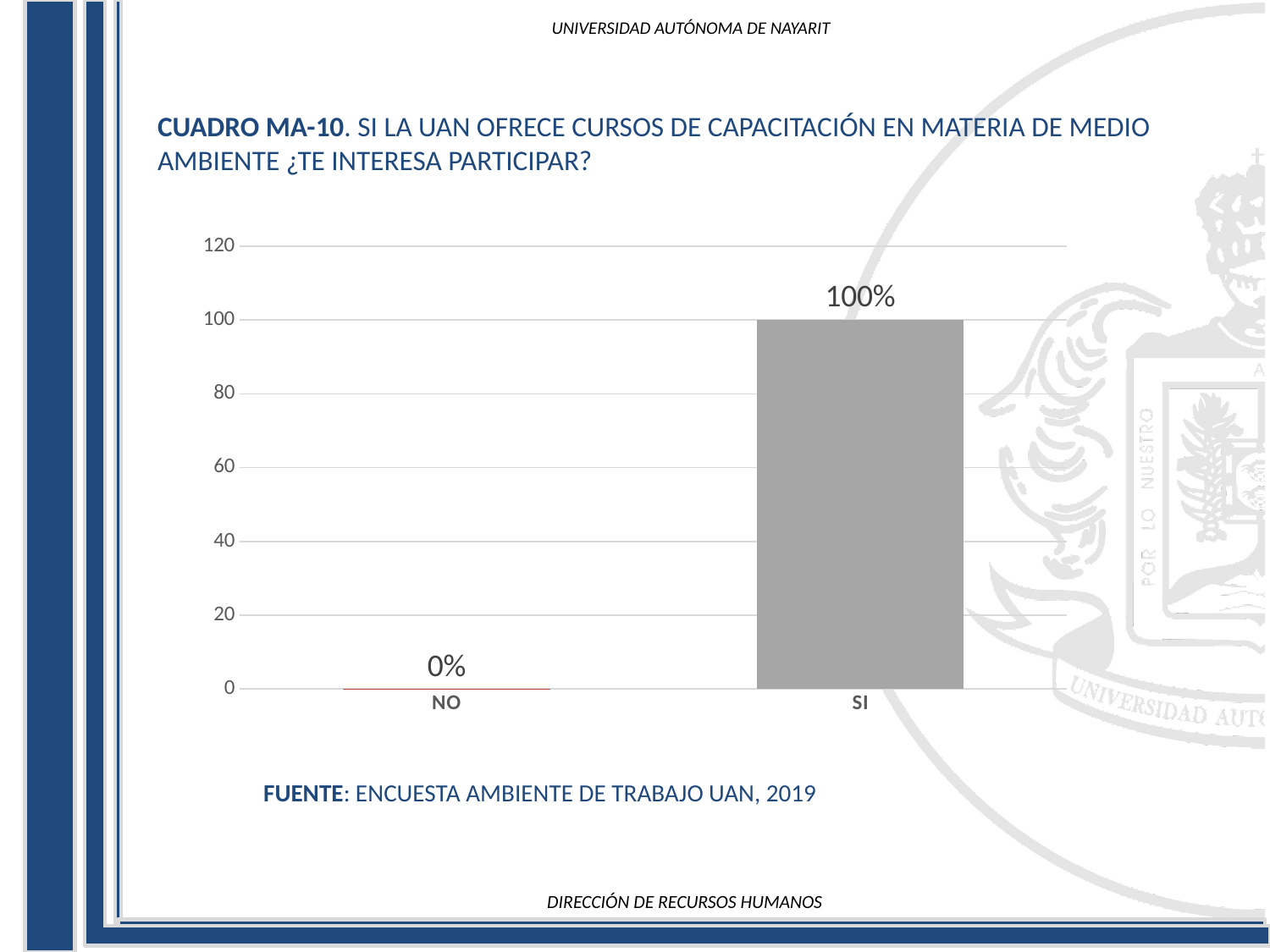
Which is larger, the value for SI or the value for NO? SI What is the value for NO? 0% What is the highest value shown on the vertical axis? 120 What kind of chart is shown on the slide? bar chart What is the difference between the values for SI and NO? 100% Which category has the lowest value? NO Is the value for SI greater or less than 80? greater What is the value for SI? 100% What source is cited below the chart? ENCUESTA AMBIENTE DE TRABAJO UAN, 2019 Which category has the highest value? SI How many categories are shown on the x axis? 2